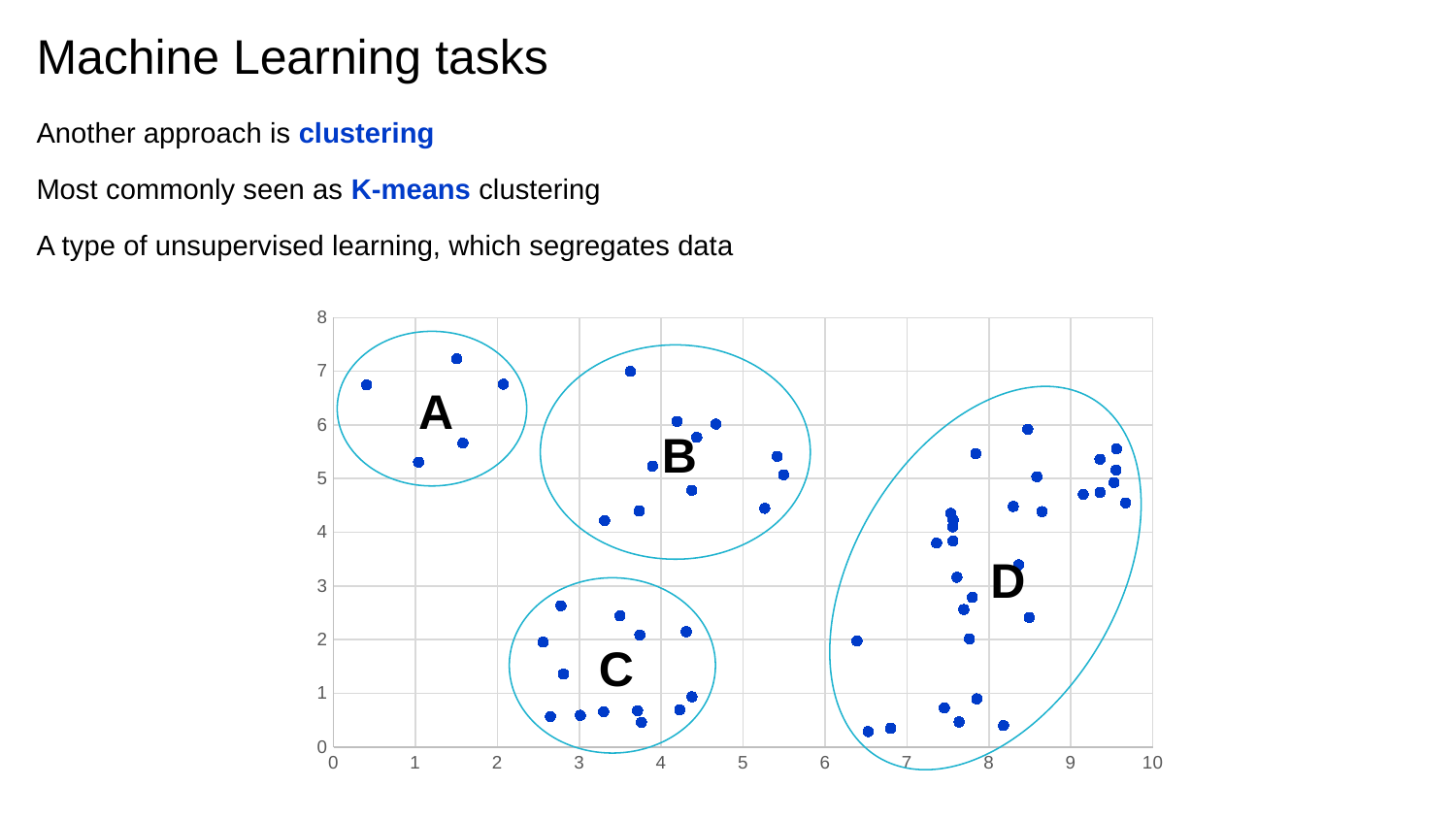
Which cluster is located at the lowest x values on the chart? A Is the x value of every point in cluster B greater or less than 2? greater Which cluster contains the fewest data points? A Is the x value of every point in cluster D greater or less than 6? greater Is the y value of every point in cluster C greater or less than 3? less What is the maximum value shown on the x axis? 10 What is the maximum value shown on the y axis? 8 What kind of chart is shown on the slide? scatter plot How many clusters are circled and labelled on the chart? 4 Which cluster contains the most data points? D